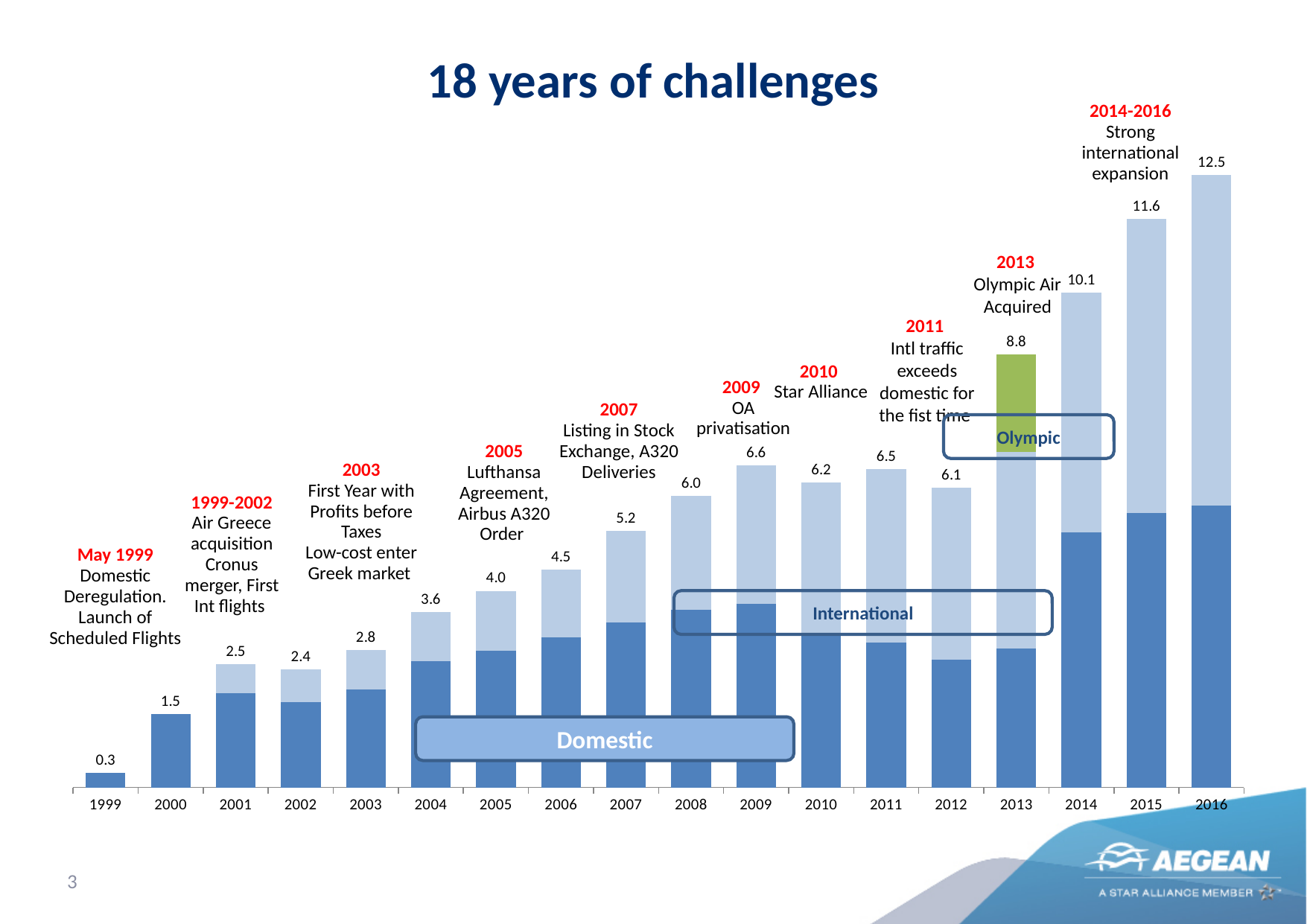
What is the difference between the total values for 2013 and 2012? 2.7 What kind of chart is shown on the slide? Stacked bar chart How many years are shown on the x axis? 18 What is the total value shown for 2009? 6.6 Which segment is shown in green in the 2013 bar? Olympic Which year has the highest total value? 2016 Which year has the lowest total value? 1999 What is the difference between the total values for 2016 and 2015? 0.9 What is the total value shown for 1999? 0.3 What is the total value shown for 2016? 12.5 What is the total value shown for 2013? 8.8 Which year has a larger total value, 2010 or 2011? 2011